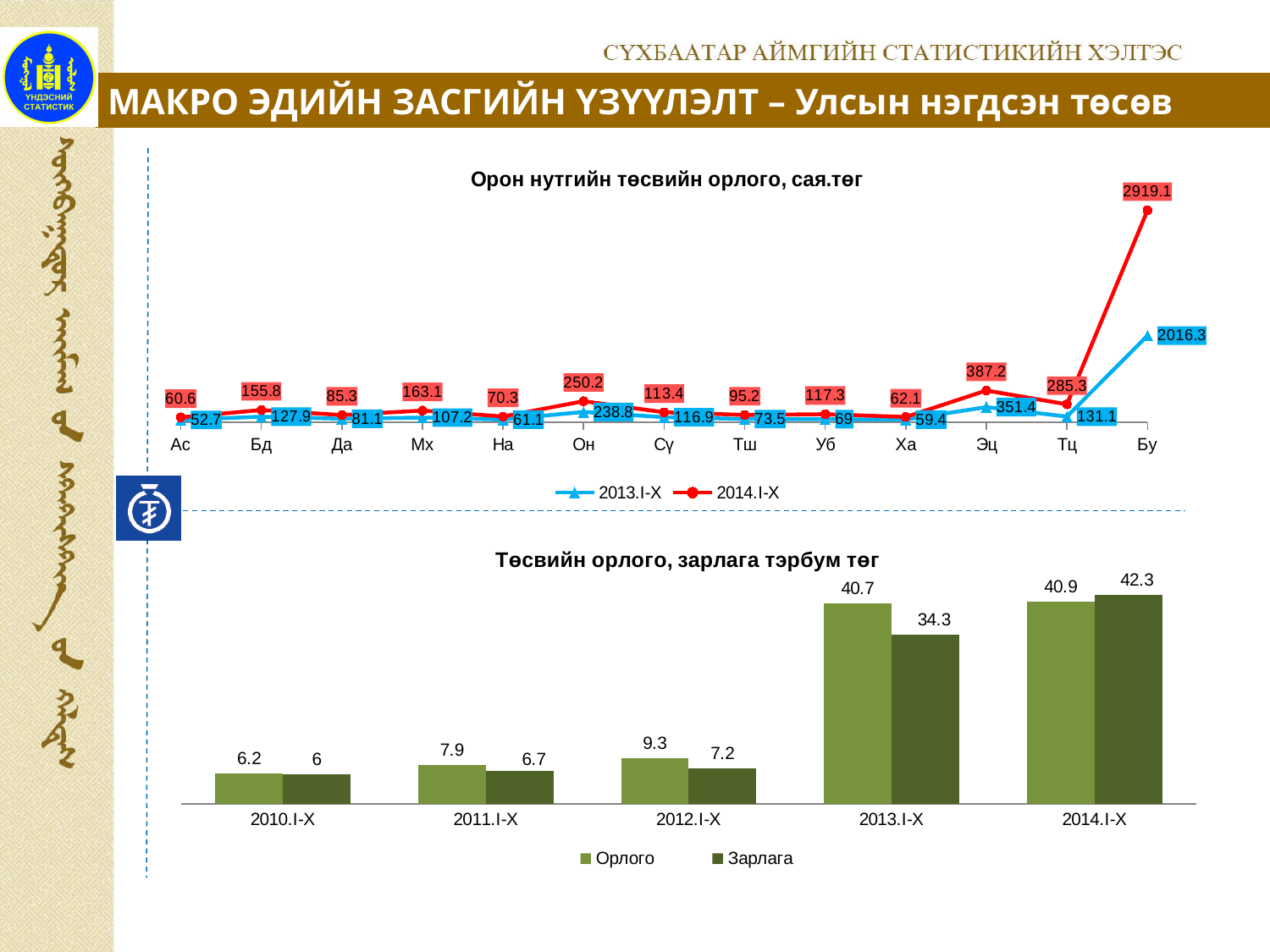
In the top chart 'Орон нутгийн төсвийн орлого, сая.төг', how many categories are shown on the x axis? 13 In the top chart 'Орон нутгийн төсвийн орлого, сая.төг', what is the 2014.I-X value for Бу? 2919.1 In the top chart 'Орон нутгийн төсвийн орлого, сая.төг', which category has the lowest 2013.I-X value? Ас In the top chart 'Орон нутгийн төсвийн орлого, сая.төг', what is the 2013.I-X value for Эц? 351.4 In the bottom chart 'Төсвийн орлого, зарлага тэрбум төг', what is the Зарлага value for 2013.I-X? 34.3 In the bottom chart 'Төсвийн орлого, зарлага тэрбум төг', what is the difference between Орлого and Зарлага for 2012.I-X? 2.1 In the top chart 'Орон нутгийн төсвийн орлого, сая.төг', which category has the highest 2014.I-X value? Бу In the top chart 'Орон нутгийн төсвийн орлого, сая.төг', what is the difference between the 2014.I-X and 2013.I-X values for Тц? 154.2 In the bottom chart 'Төсвийн орлого, зарлага тэрбум төг', which is larger for 2014.I-X, Орлого or Зарлага? Зарлага In the bottom chart 'Төсвийн орлого, зарлага тэрбум төг', does the Орлого value rise or fall from 2010.I-X to 2014.I-X? Rise In the top chart 'Орон нутгийн төсвийн орлого, сая.төг', how many series does the legend list? 2 What kind of chart is the top chart 'Орон нутгийн төсвийн орлого, сая.төг'? Line chart